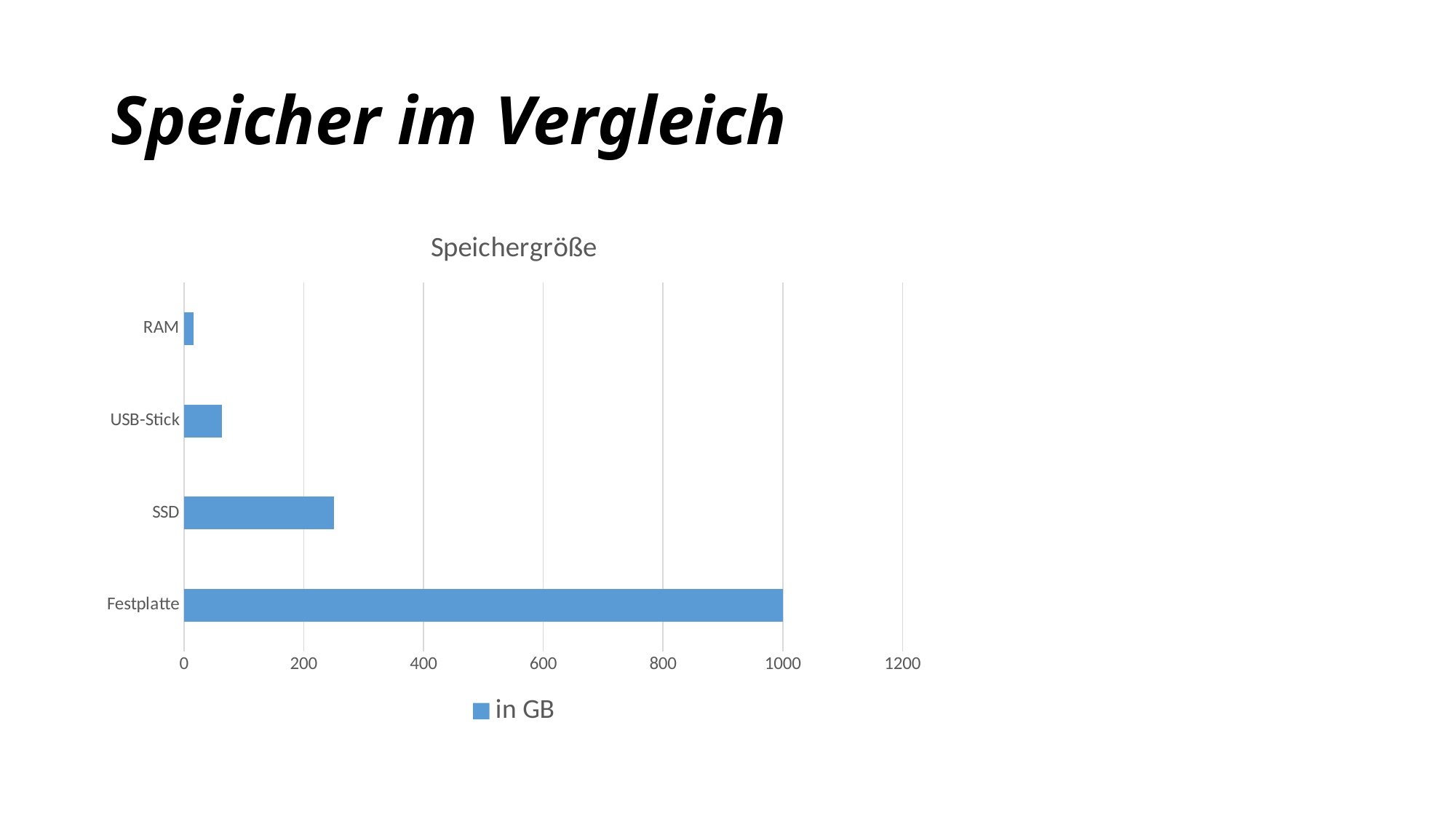
What type of chart is shown on the slide? bar chart Which is larger, the value for SSD or the value for USB-Stick? SSD Is the value for SSD greater or less than 400? less How many series does the legend list? 1 How many categories are shown in the chart? 4 Which category has the highest value? Festplatte What is the value for Festplatte? 1000 What is the legend entry of the chart? in GB Is the value for USB-Stick greater or less than 200? less Which category has the lowest value? RAM Is the value for SSD greater or less than 200? greater What is the title of the chart? Speichergröße